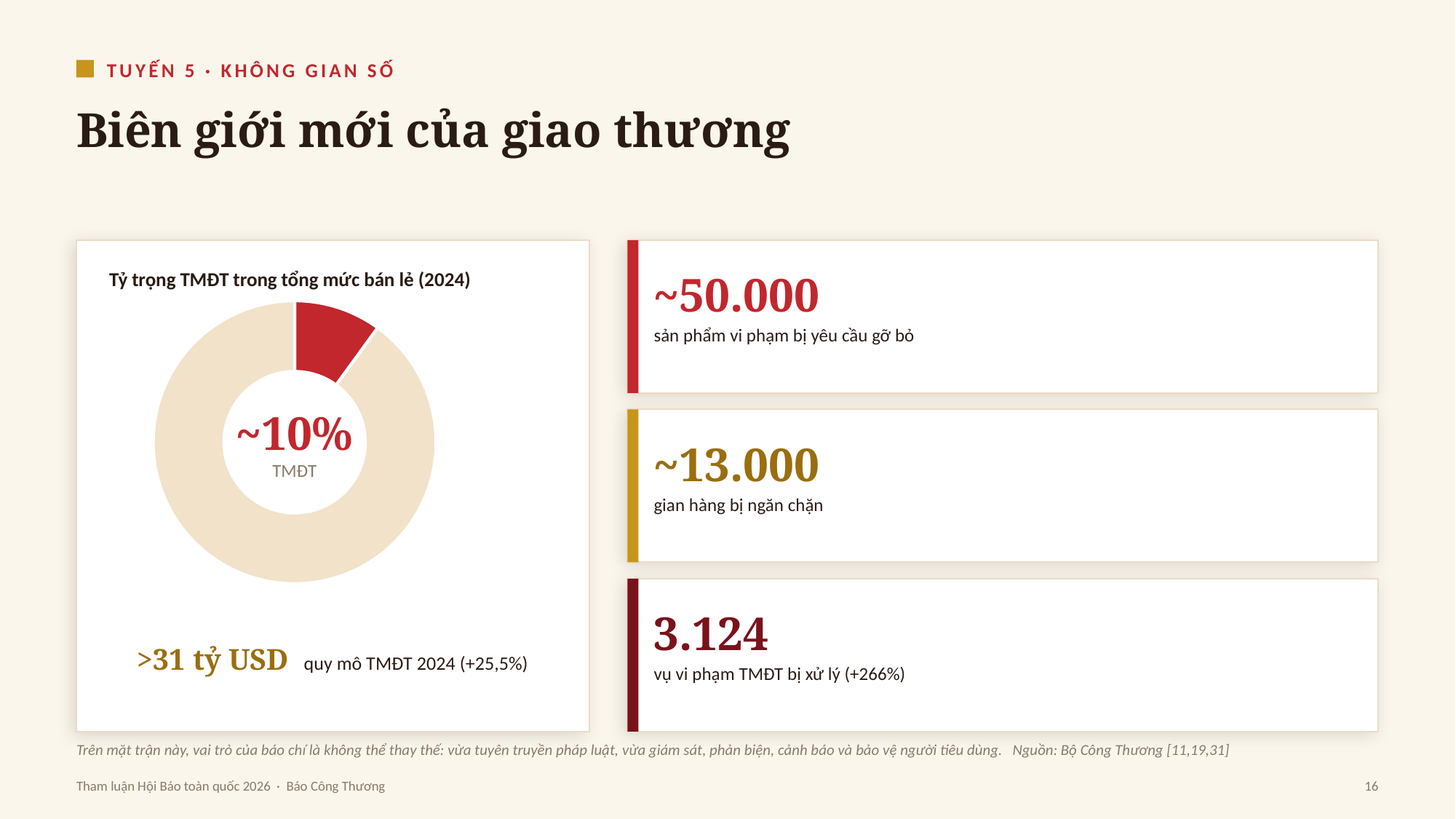
What colour is the TMĐT slice in the donut chart? Red Which slice of the donut chart is larger: the TMĐT slice or the remaining (beige) slice? The remaining (beige) slice Which year does the donut chart refer to? 2024 What kind of chart is shown on the slide? Pie (donut) chart What share of total retail does the TMĐT slice represent, as labelled in the centre of the donut chart? ~10% Is the TMĐT slice of the donut chart greater or less than 50% of the whole? less What is the title of the donut chart? Tỷ trọng TMĐT trong tổng mức bán lẻ (2024) How many slices does the donut chart have? 2